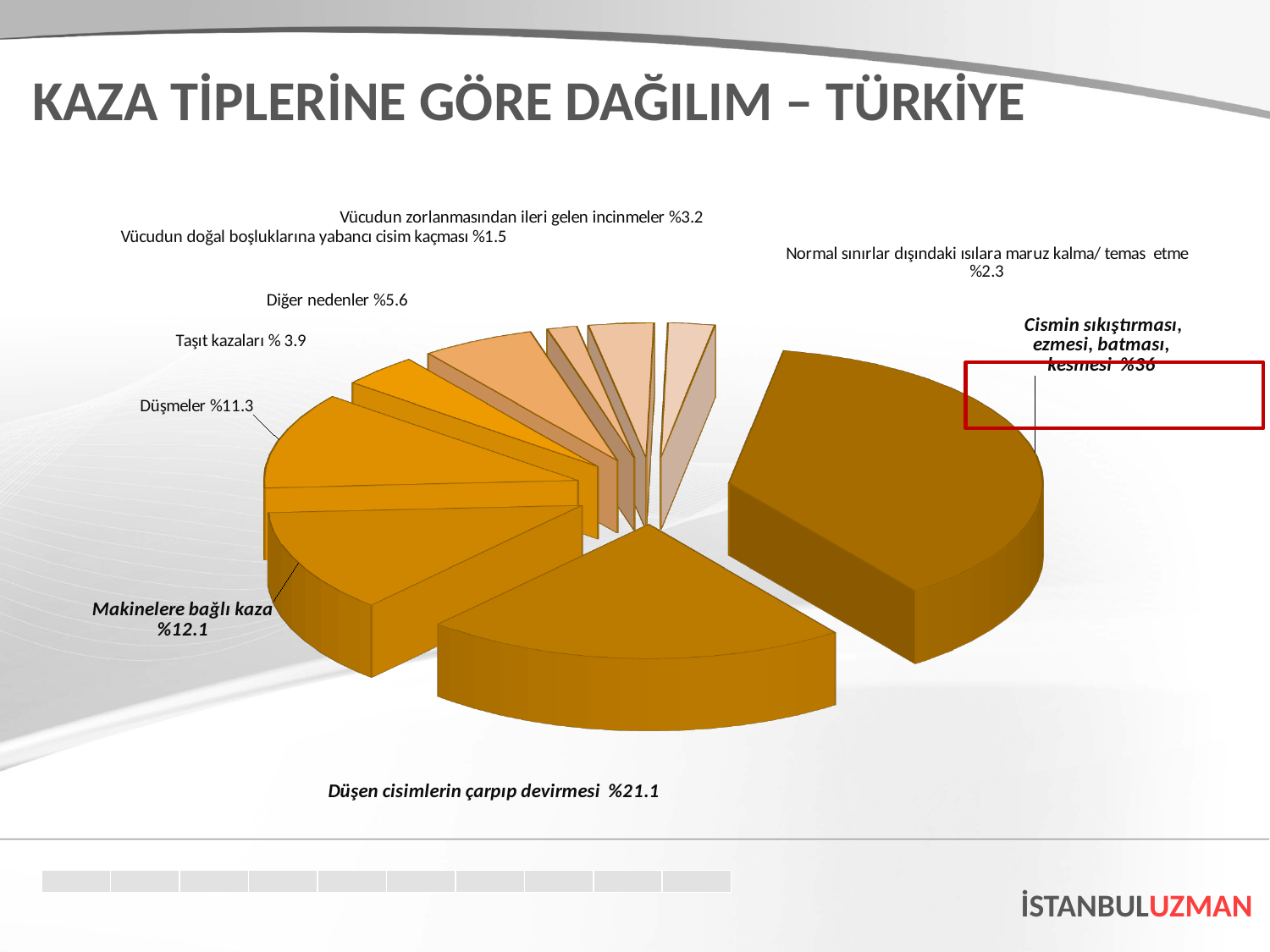
How many slices does the pie chart have? 9 What is the title of the slide containing the pie chart? KAZA TİPLERİNE GÖRE DAĞILIM – TÜRKİYE What percentage is shown for Düşmeler? %11.3 Which accident type has the smallest share of the pie? Vücudun doğal boşluklarına yabancı cisim kaçması What percentage is shown for Diğer nedenler? %5.6 Which accident type has the largest share of the pie? Cismin sıkıştırması, ezmesi, batması, kesmesi What percentage is shown for Taşıt kazaları? % 3.9 What percentage is shown for Makinelere bağlı kaza? %12.1 What type of chart is shown on the slide? Pie chart Which is larger: the share for Düşmeler or the share for Makinelere bağlı kaza? Makinelere bağlı kaza What percentage is shown for Düşen cisimlerin çarpıp devirmesi? %21.1 What is the difference in percentage points between Cismin sıkıştırması, ezmesi, batması, kesmesi (%36) and Düşen cisimlerin çarpıp devirmesi (%21.1)? 14.9